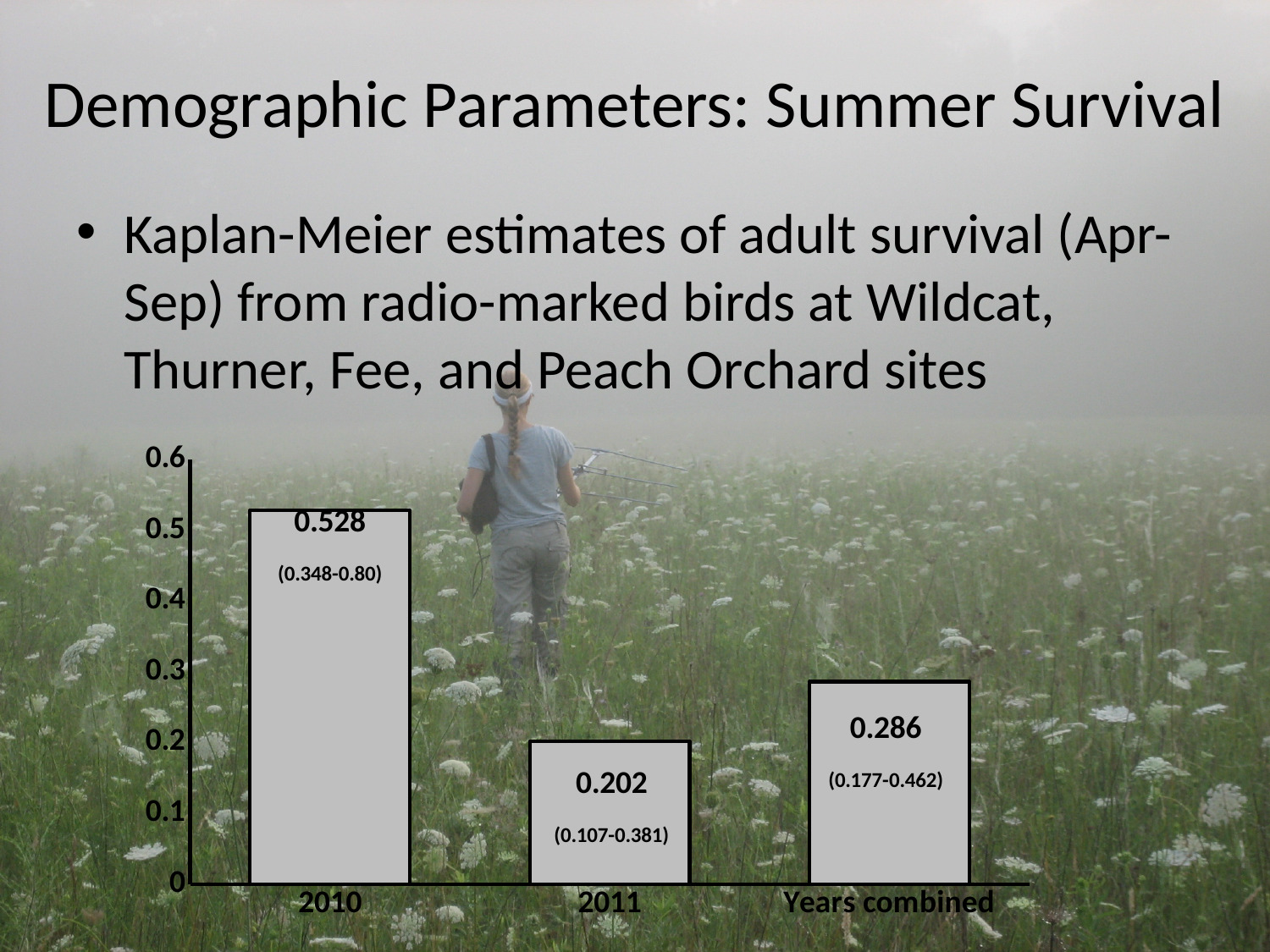
What is the summer survival estimate for 2010? 0.528 What is the summer survival estimate for Years combined? 0.286 How many bars are shown in the chart? 3 What is the difference between the 2010 and 2011 survival estimates? 0.326 Is the survival estimate for 2010 greater or less than 0.5? greater What confidence interval is printed for the 2011 bar? (0.107-0.381) Which is larger, the survival estimate for 2011 or for Years combined? Years combined What kind of chart is shown on the slide? bar chart What is the summer survival estimate for 2011? 0.202 What is the maximum value shown on the y axis? 0.6 Which category has the highest survival estimate? 2010 Which category has the lowest survival estimate? 2011